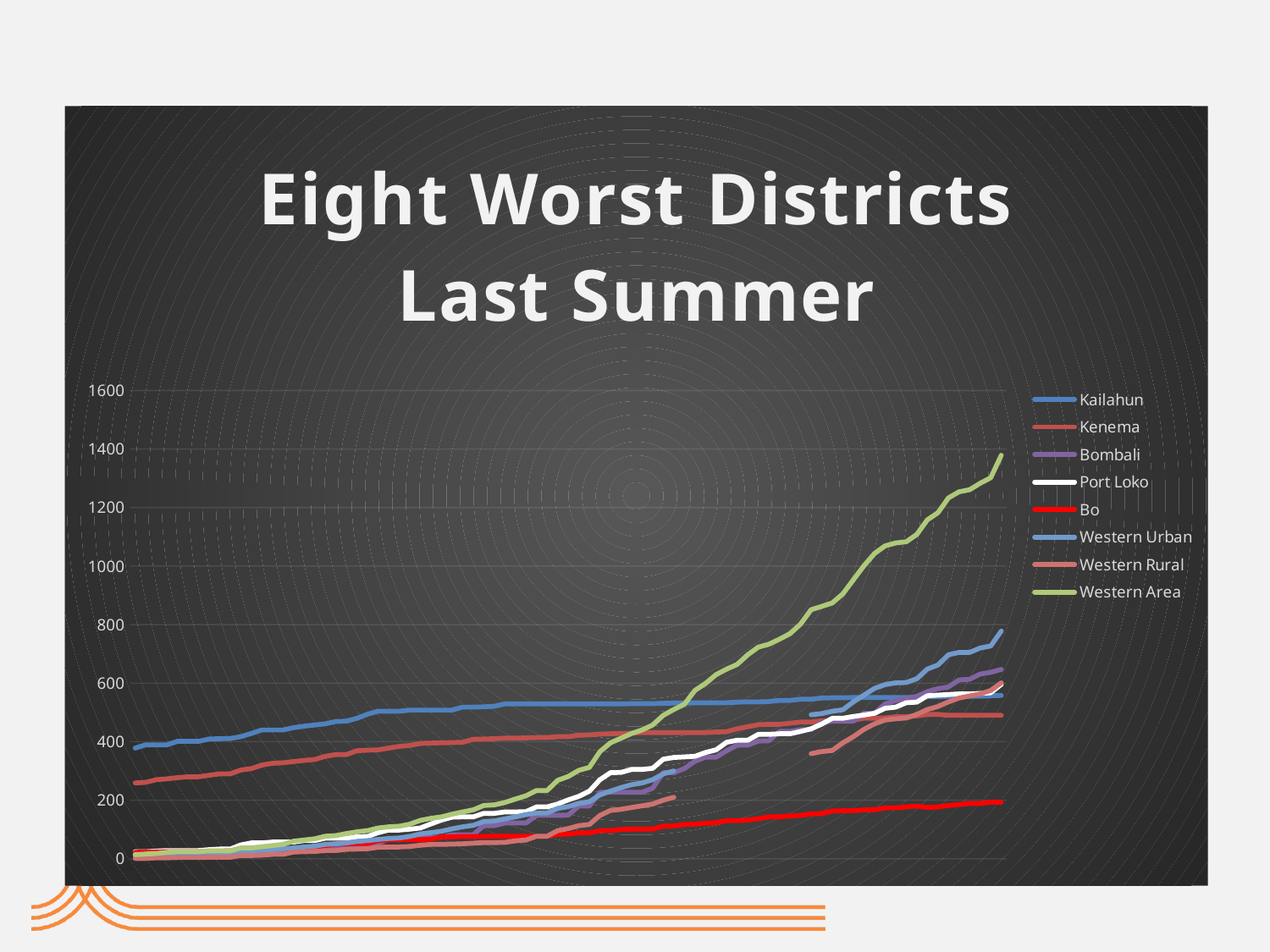
How many series does the legend list? 8 What kind of chart is shown on the slide? Line chart Is the final value for Western Urban greater or less than 600? greater Which series has the lowest value at the right end of the chart? Bo At the right end of the chart, which is larger: Western Urban or Kailahun? Western Urban Which series reaches the highest value at the right end of the chart? Western Area Is the final value for Bo greater or less than 400? less Is the final value for Western Area greater or less than 1200? greater Does the Western Area line rise or fall along the x axis? Rises Which series is drawn in green? Western Area What is the title of the chart? Eight Worst Districts Last Summer